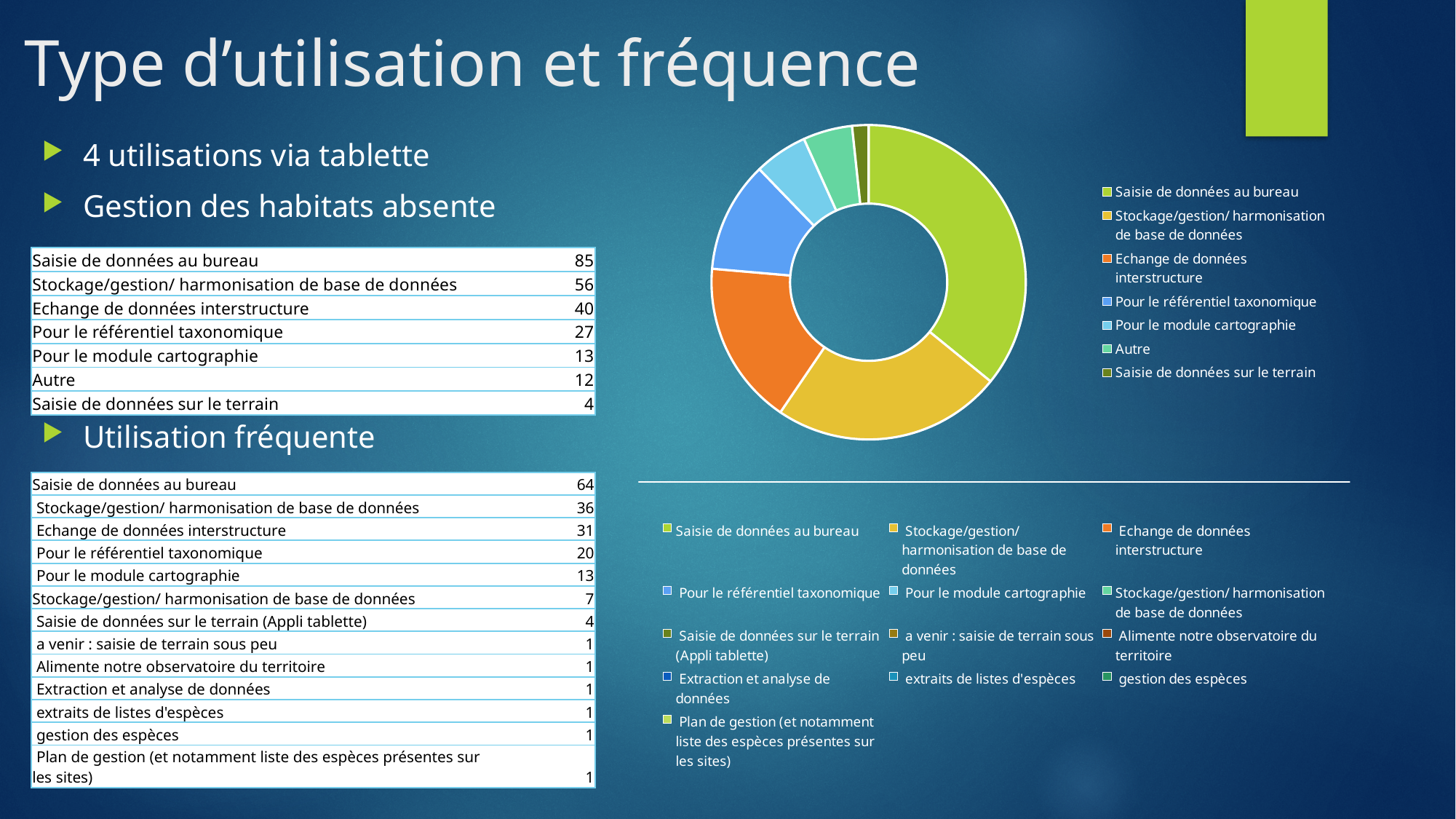
Which category is shown in light green (the largest slice) in the doughnut chart? Saisie de données au bureau In the doughnut chart, which slice is larger: Pour le référentiel taxonomique or Pour le module cartographie? Pour le référentiel taxonomique What colour represents Echange de données interstructure in the doughnut chart? Orange What kind of chart is shown on the slide? Doughnut (pie) chart In the doughnut chart, which slice is larger: Stockage/gestion/ harmonisation de base de données or Echange de données interstructure? Stockage/gestion/ harmonisation de base de données In the doughnut chart, which slice is larger: Saisie de données au bureau or Echange de données interstructure? Saisie de données au bureau Which category has the smallest slice in the doughnut chart? Saisie de données sur le terrain How many categories does the doughnut chart's legend list? 7 Which category has the largest slice in the doughnut chart? Saisie de données au bureau